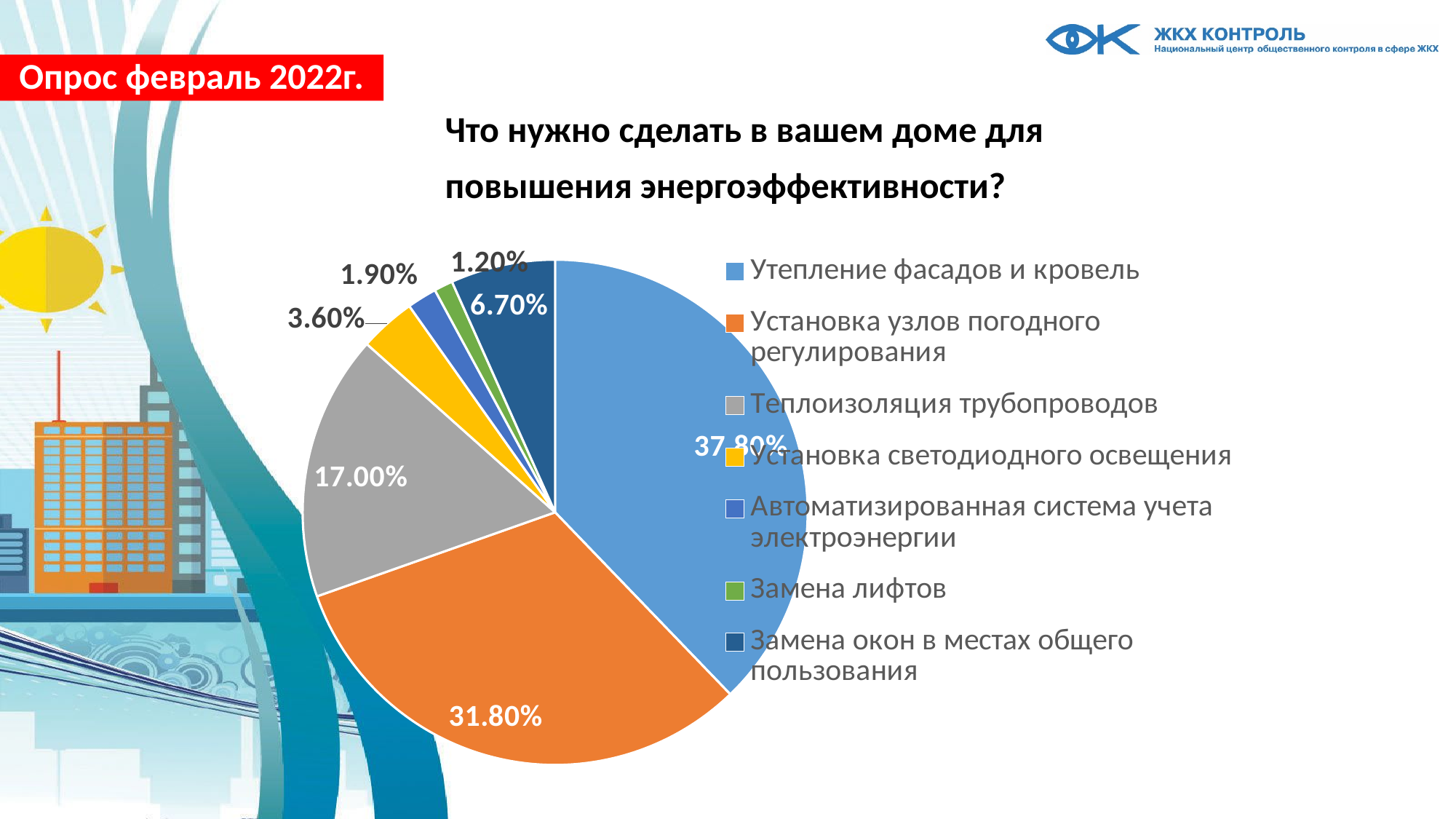
Which category has the largest slice of the pie? Утепление фасадов и кровель What value is shown for "Замена лифтов"? 1.20% What kind of chart is shown on the slide? Pie chart Which is larger: the slice for "Установка светодиодного освещения" or the slice for "Автоматизированная система учета электроэнергии"? Установка светодиодного освещения What is the title of the chart? Что нужно сделать в вашем доме для повышения энергоэффективности? What is the difference in percentage points between "Установка узлов погодного регулирования" and "Теплоизоляция трубопроводов"? 14.80 Which category has the smallest slice of the pie? Замена лифтов What value is shown for "Теплоизоляция трубопроводов"? 17.00% How many slices does the pie chart have? 7 What share of the pie is labelled for "Установка узлов погодного регулирования"? 31.80% What value is shown for "Установка светодиодного освещения"? 3.60% What value is shown for "Замена окон в местах общего пользования"? 6.70%